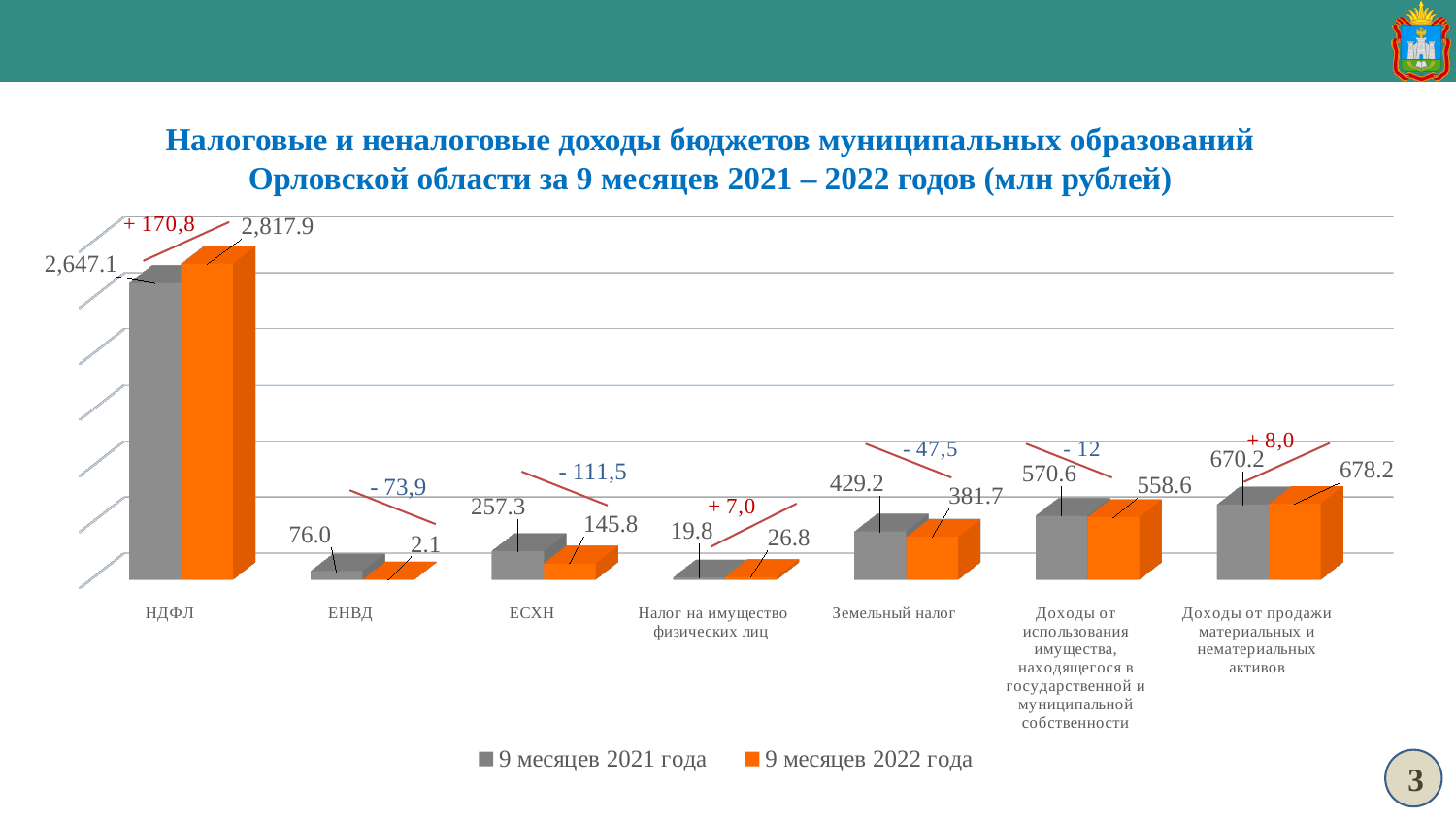
Which is larger for Налог на имущество физических лиц: the value for 9 месяцев 2021 года or for 9 месяцев 2022 года? 9 месяцев 2022 года What kind of chart is shown on the slide? Bar chart What is the value for ЕСХН in the series 9 месяцев 2021 года? 257.3 Which colour represents the series 9 месяцев 2022 года? Orange What is the value for Земельный налог in the series 9 месяцев 2022 года? 381.7 Which category has the highest value in the series 9 месяцев 2021 года? НДФЛ How many categories are shown on the x axis of the chart? 7 How many series does the legend list? 2 Which category has the lowest value in the series 9 месяцев 2022 года? ЕНВД What is the value for ЕНВД in the series 9 месяцев 2021 года? 76.0 What is the value for НДФЛ in the series 9 месяцев 2022 года? 2,817.9 What is the difference between the 9 месяцев 2022 года and 9 месяцев 2021 года values for ЕСХН? 111.5